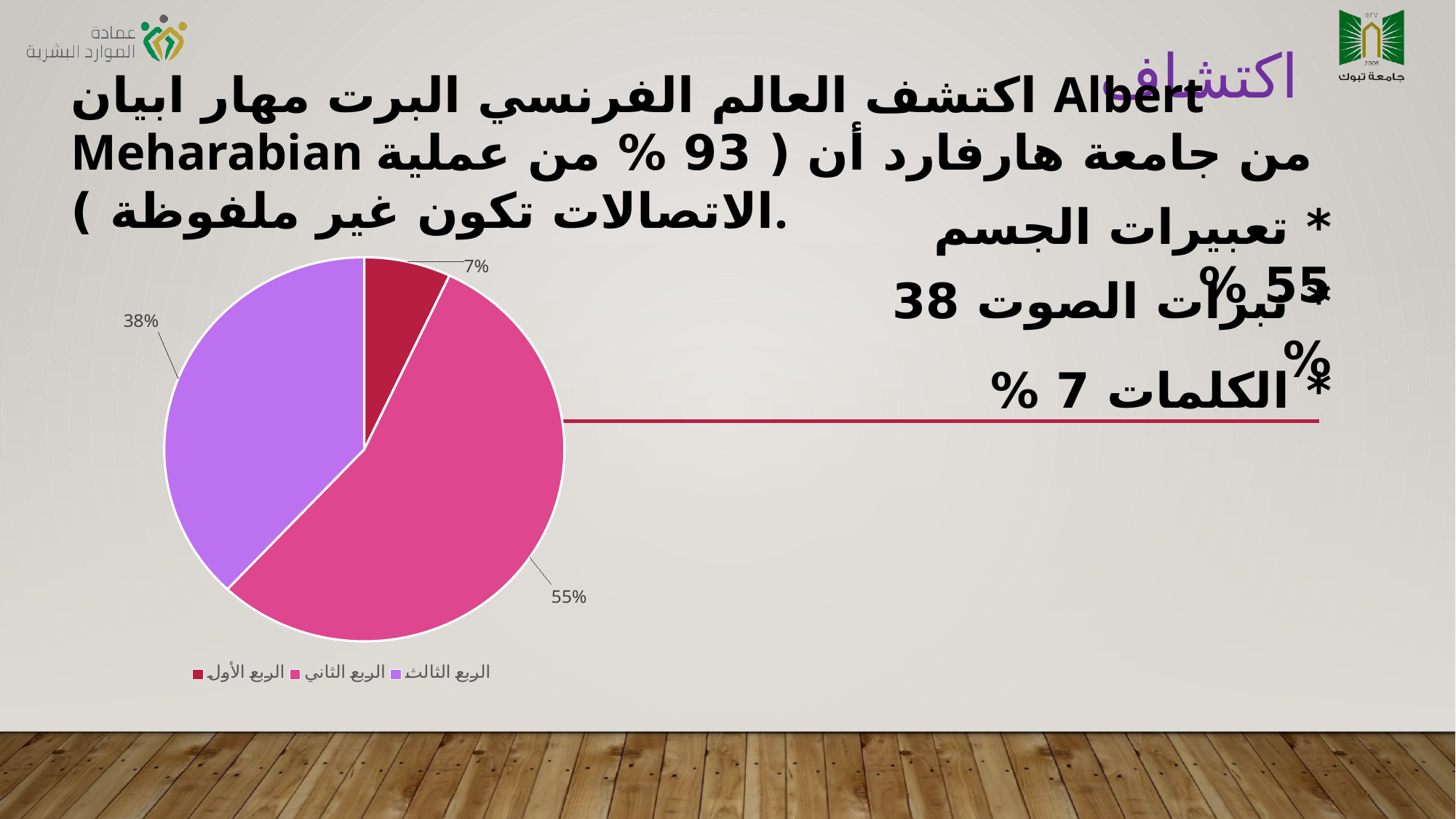
Which slice of the pie chart is the largest? الربع الثاني Which slice of the pie chart is the smallest? الربع الأول What is the difference between the الربع الثاني slice and the الربع الثالث slice? 17% Which is larger, the الربع الثالث slice or the الربع الأول slice? الربع الثالث What is the combined share of the الربع الأول and الربع الثالث slices? 45% What percentage is shown for the slice labelled الربع الأول? 7% How many slices does the pie chart have? 3 What percentage is shown for the slice labelled الربع الثاني? 55% What colour is the الربع الثالث slice in the pie chart? purple What kind of chart is shown on the slide? pie chart What percentage is shown for the slice labelled الربع الثالث? 38% How many entries does the pie chart's legend list? 3